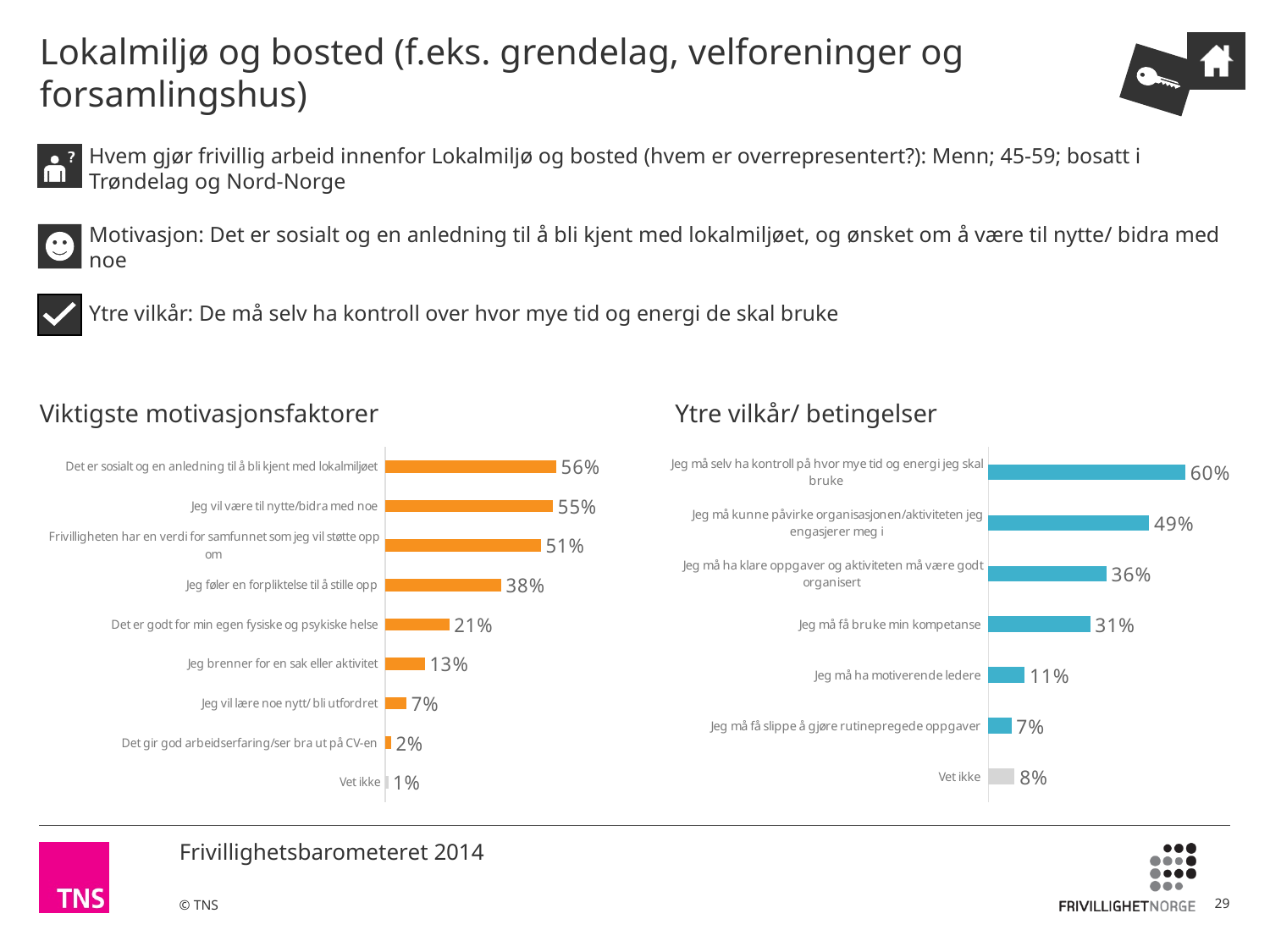
In the 'Viktigste motivasjonsfaktorer' chart, which category has the highest value? Det er sosialt og en anledning til å bli kjent med lokalmiljøet In the 'Ytre vilkår/ betingelser' chart, which category has the lowest value? Jeg må få slippe å gjøre rutinepregede oppgaver In the 'Ytre vilkår/ betingelser' chart, what is the difference between 'Jeg må selv ha kontroll på hvor mye tid og energi jeg skal bruke' and 'Jeg må kunne påvirke organisasjonen/aktiviteten jeg engasjerer meg i'? 11% How many categories are shown in the 'Viktigste motivasjonsfaktorer' chart? 9 In the 'Ytre vilkår/ betingelser' chart, what is the value for 'Jeg må få bruke min kompetanse'? 31% How many categories are shown in the 'Ytre vilkår/ betingelser' chart? 7 In the 'Viktigste motivasjonsfaktorer' chart, what is the value for 'Jeg føler en forpliktelse til å stille opp'? 38% In the 'Ytre vilkår/ betingelser' chart, which is larger: 'Jeg må ha motiverende ledere' or 'Vet ikke'? Jeg må ha motiverende ledere In the 'Viktigste motivasjonsfaktorer' chart, which is larger: 'Jeg vil lære noe nytt/ bli utfordret' or 'Det gir god arbeidserfaring/ser bra ut på CV-en'? Jeg vil lære noe nytt/ bli utfordret In the 'Viktigste motivasjonsfaktorer' chart, what is the difference between 'Det er godt for min egen fysiske og psykiske helse' and 'Jeg brenner for en sak eller aktivitet'? 8% What kind of chart is the 'Ytre vilkår/ betingelser' chart? Bar chart What colour are the bars in the 'Viktigste motivasjonsfaktorer' chart? Orange